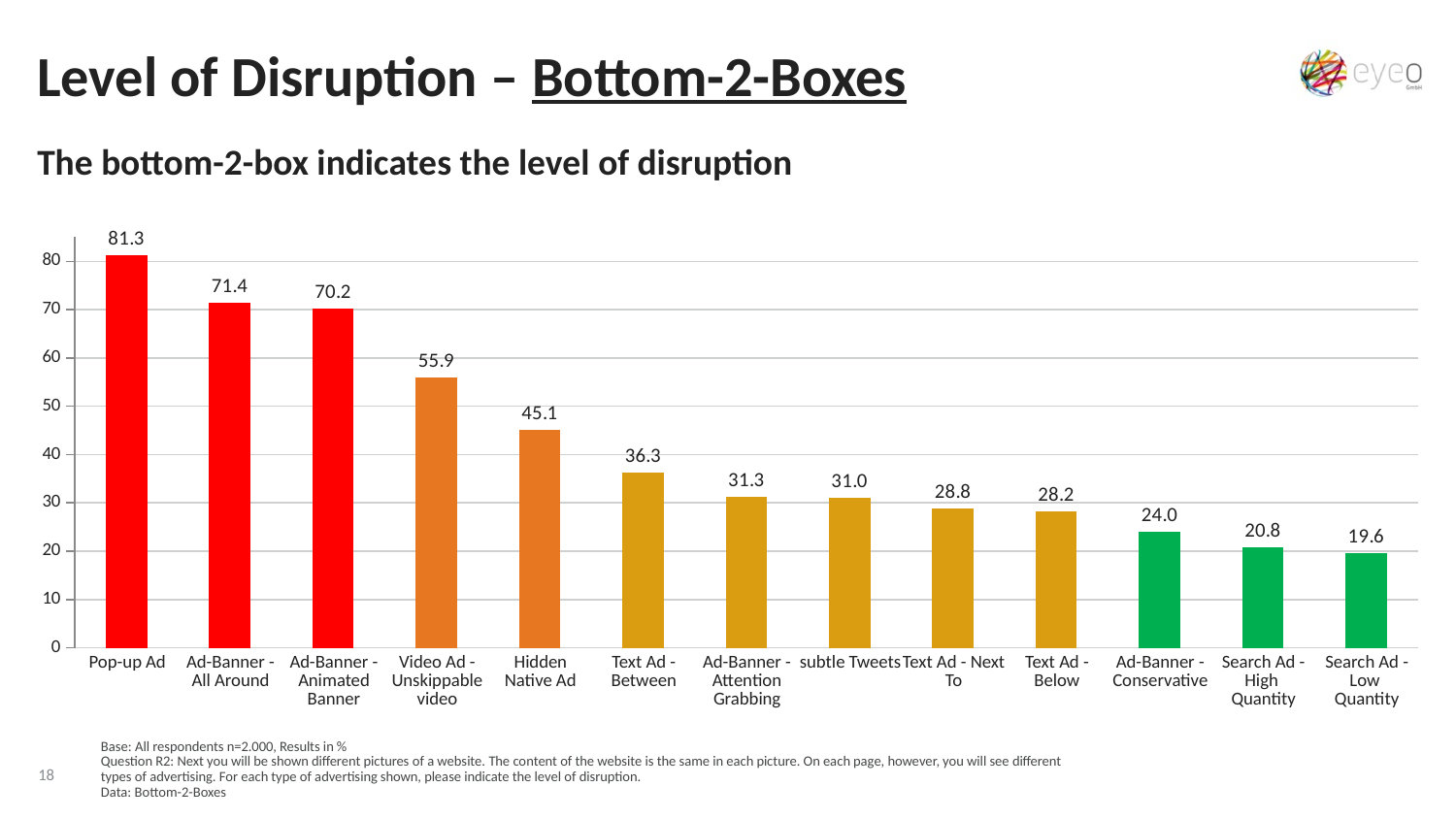
Which category has the highest value? Pop-up Ad Which is larger, the value for Hidden Native Ad or the value for Text Ad - Between? Hidden Native Ad How many categories are shown on the x axis? 13 What is the value for Video Ad - Unskippable video? 55.9 Is the value for Ad-Banner - Conservative greater or less than 30? less What is the value for Search Ad - Low Quantity? 19.6 What colour are the bars for the three highest categories? red What is the difference between the values for Pop-up Ad and Ad-Banner - All Around? 9.9 Which category has the lowest value? Search Ad - Low Quantity What is the value for Pop-up Ad? 81.3 Do the values rise or fall from left to right along the x axis? fall What kind of chart is shown on the slide? bar chart